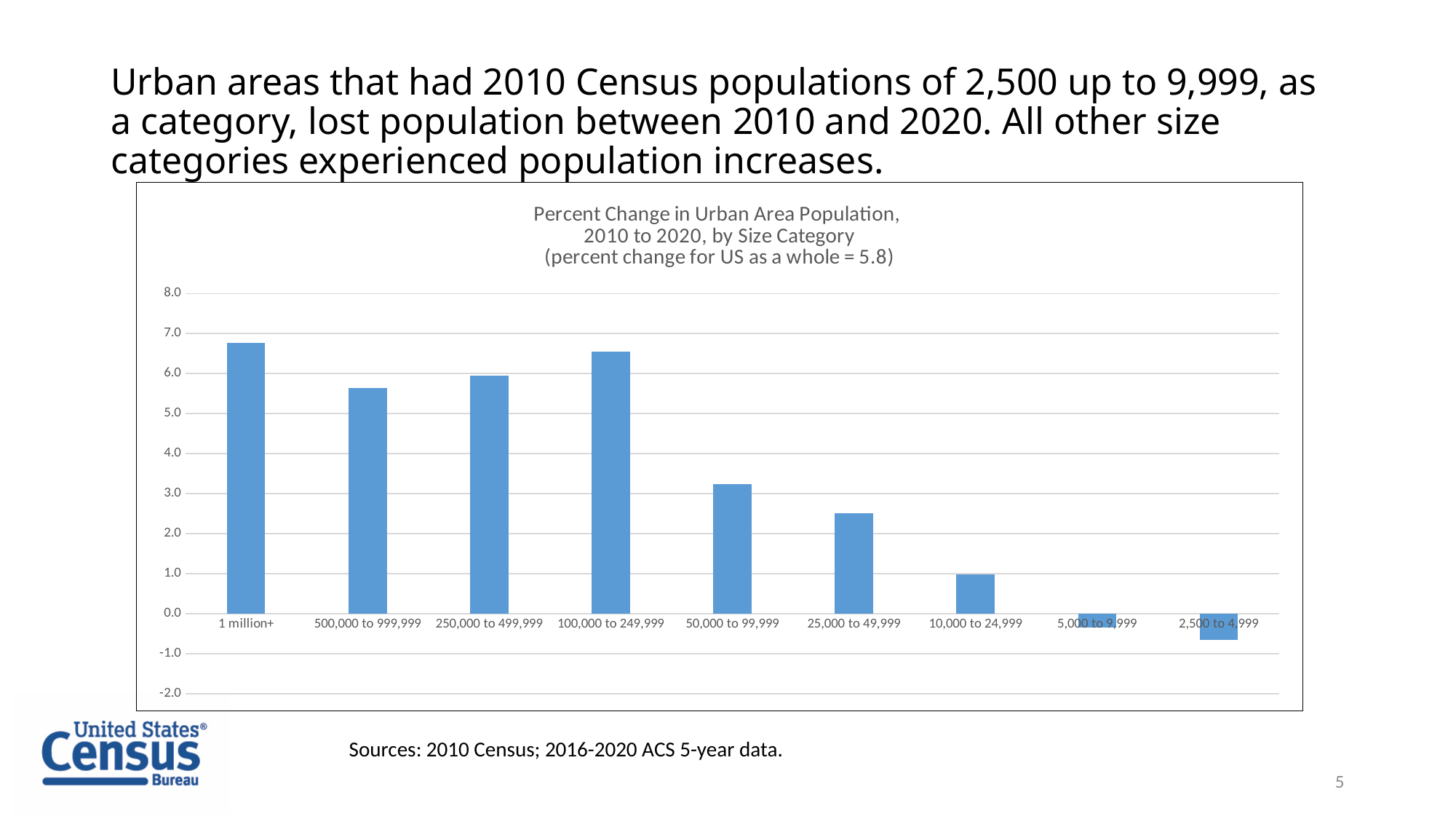
Which size category has the lowest percent change in urban area population? 2,500 to 4,999 Is the value for 25,000 to 49,999 greater or less than 3.0? less How many size categories are plotted on the chart? 9 Is the value for 50,000 to 99,999 greater or less than 4.0? less Which size category has the highest percent change in urban area population? 1 million+ Is the value for 2,500 to 4,999 greater or less than 0.0? less According to the chart title, what is the percent change for the US as a whole? 5.8 Which has the larger percent change: 100,000 to 249,999 or 500,000 to 999,999? 100,000 to 249,999 What kind of chart is shown on the slide? bar chart Moving from the largest size category on the left to the smallest on the right, do the values generally rise or fall? fall Which has the larger percent change: 50,000 to 99,999 or 10,000 to 24,999? 50,000 to 99,999